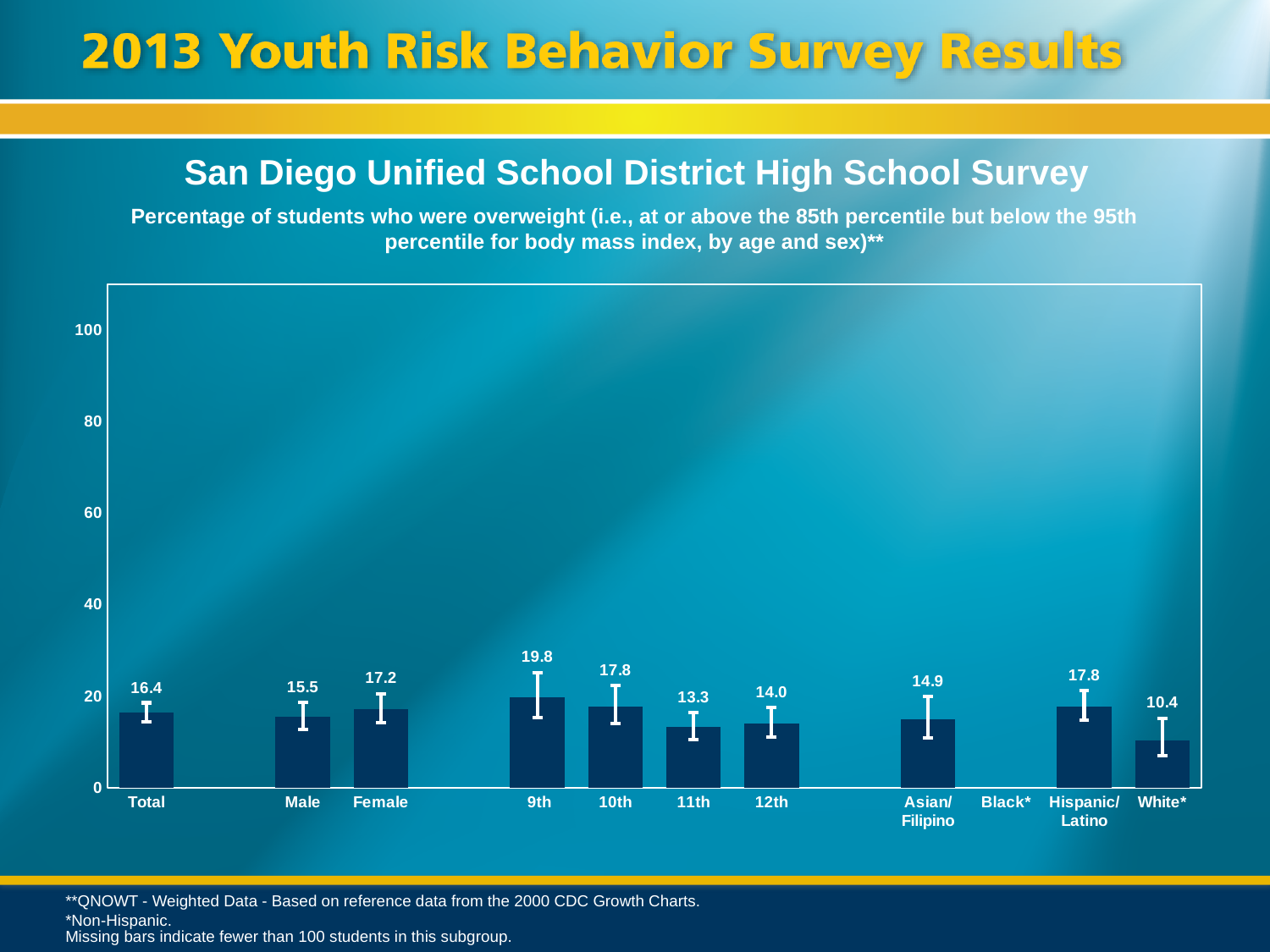
What is the difference between the values for Female and Male? 1.7 Which category label has no bar plotted? Black* What is the value for White*? 10.4 What is the value for 9th grade? 19.8 Which is larger, the value for Male or the value for Female? Female What is the value for Total? 16.4 What kind of chart is shown on the slide? bar chart Is the value for Total greater or less than 20? less What is the value for Hispanic/Latino? 17.8 Which category has the highest value? 9th Which category has the lowest value among the plotted bars? White* What is the difference between the values for 9th and 11th grade? 6.5